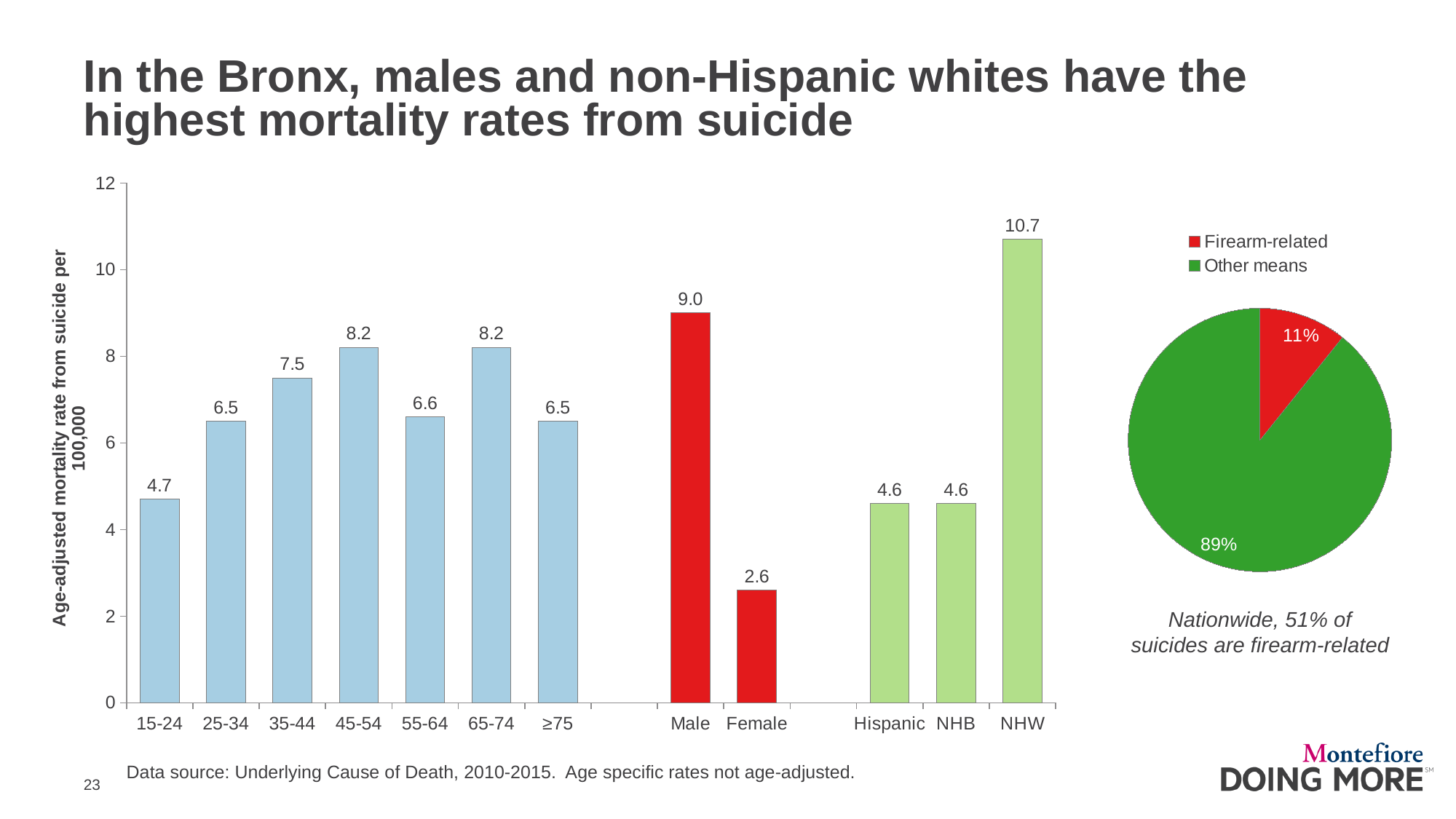
In the pie chart, what share of suicides is firearm-related? 11% In the bar chart, what is the suicide mortality rate for the 35-44 age group? 7.5 In the bar chart, how many bars are plotted in total? 12 In the bar chart, which has a higher suicide mortality rate, the 45-54 age group or the 55-64 age group? 45-54 How many entries does the pie chart's legend list? 2 In the bar chart, what is the difference between the NHW rate and the Hispanic rate? 6.1 In the bar chart, what is the age-adjusted mortality rate from suicide for males? 9.0 What type of chart is the chart on the left side of the slide? Bar chart In the bar chart, what is the difference between the male and female suicide mortality rates? 6.4 In the bar chart, which category has the highest suicide mortality rate? NHW In the bar chart, which category has the lowest suicide mortality rate? Female In the pie chart, what share of suicides is by other means? 89%